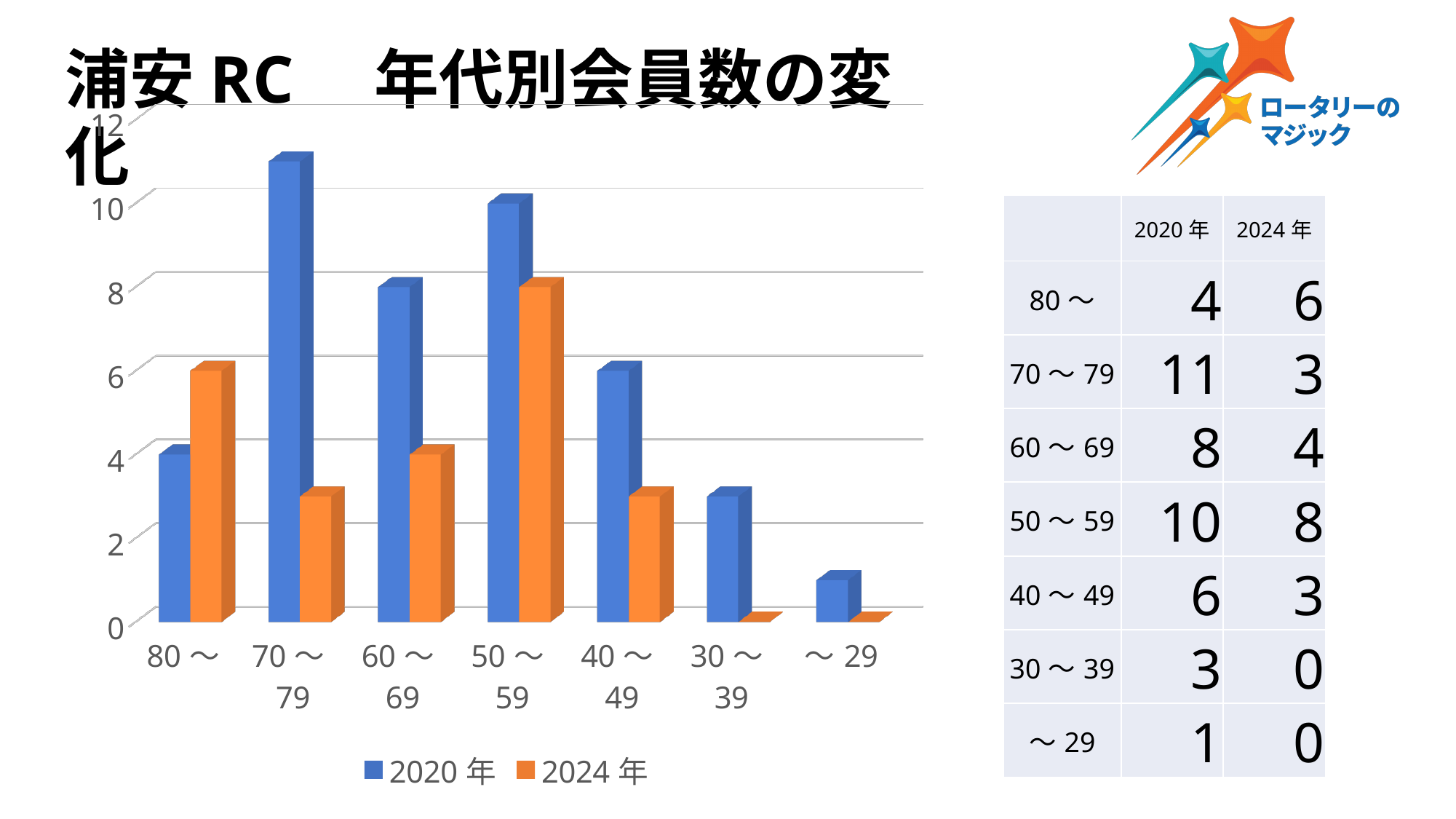
Which colour represents the 2024年 series in the chart? orange Which age category has the highest value in the 2020年 series? 70〜79 Is the 2020年 value for 50〜59 greater or less than 8? greater How many series does the chart legend list? 2 What is the difference between the 2020年 and 2024年 values for 70〜79? 8 How many age categories are shown on the x axis of the chart? 7 What kind of chart is shown on the slide? bar chart What is the value for 50〜59 in the 2024年 series? 8 Which age category has the highest value in the 2024年 series? 50〜59 Which age category has the lowest value in the 2020年 series? 〜29 What is the value for 70〜79 in the 2020年 series? 11 For the 80〜 category, which series has the larger value, 2020年 or 2024年? 2024年